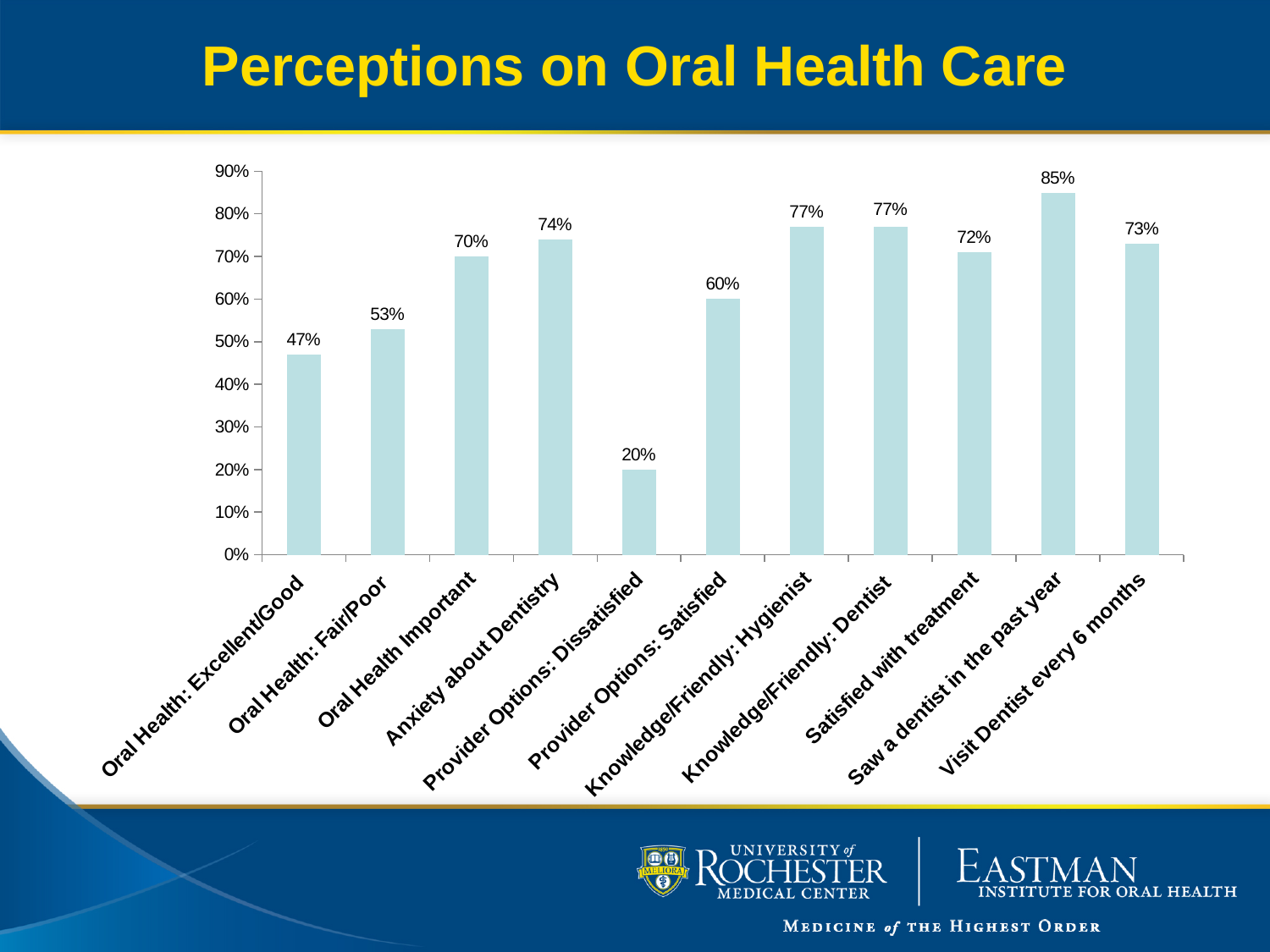
What is the title of the slide? Perceptions on Oral Health Care What is the value for Visit Dentist every 6 months? 73% Which is larger, Anxiety about Dentistry or Oral Health Important? Anxiety about Dentistry Which category has the highest value? Saw a dentist in the past year What is the value for Oral Health: Excellent/Good? 47% What is the value for Saw a dentist in the past year? 85% Which category has the lowest value? Provider Options: Dissatisfied What is the difference between Provider Options: Satisfied and Provider Options: Dissatisfied? 40% How many categories are shown in the chart? 11 What kind of chart is shown on the slide? Bar chart What is the value for Provider Options: Dissatisfied? 20% What is the difference between Oral Health: Fair/Poor and Oral Health: Excellent/Good? 6%